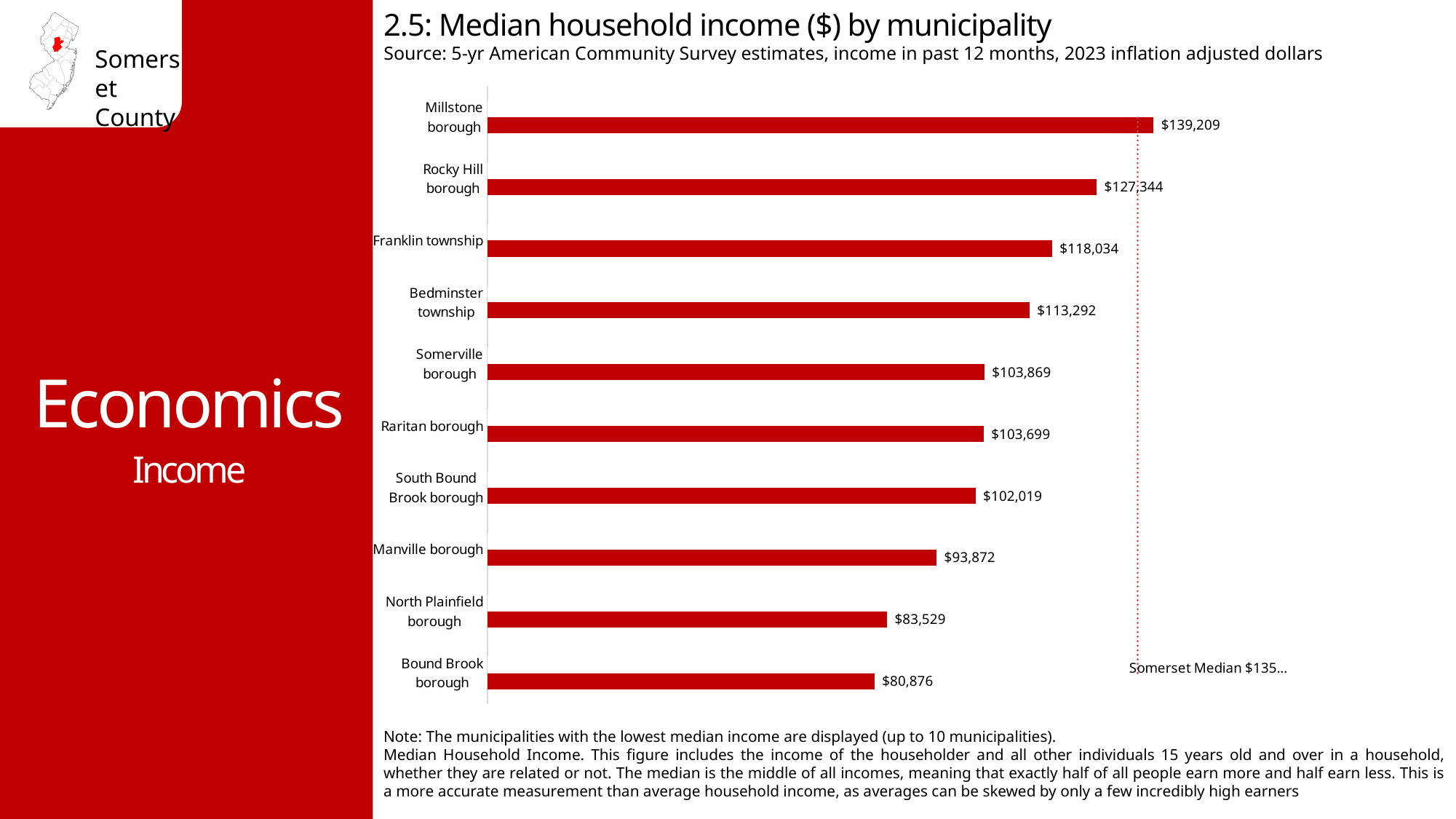
What is the median household income for Manville borough? $93,872 Which has a higher median household income, Bedminster township or Somerville borough? Bedminster township What kind of chart is used to show median household income by municipality? Bar chart What is the difference in median household income between Rocky Hill borough and Franklin township? $9,310 What is the median household income for Franklin township? $118,034 What is the median household income for Millstone borough? $139,209 How many municipalities are shown on the chart? 10 Which municipality has the highest median household income on the chart? Millstone borough What is the title of the chart? 2.5: Median household income ($) by municipality Which municipality has the lowest median household income on the chart? Bound Brook borough What is the median household income for Bound Brook borough? $80,876 What is the difference in median household income between Millstone borough and Bound Brook borough? $58,333